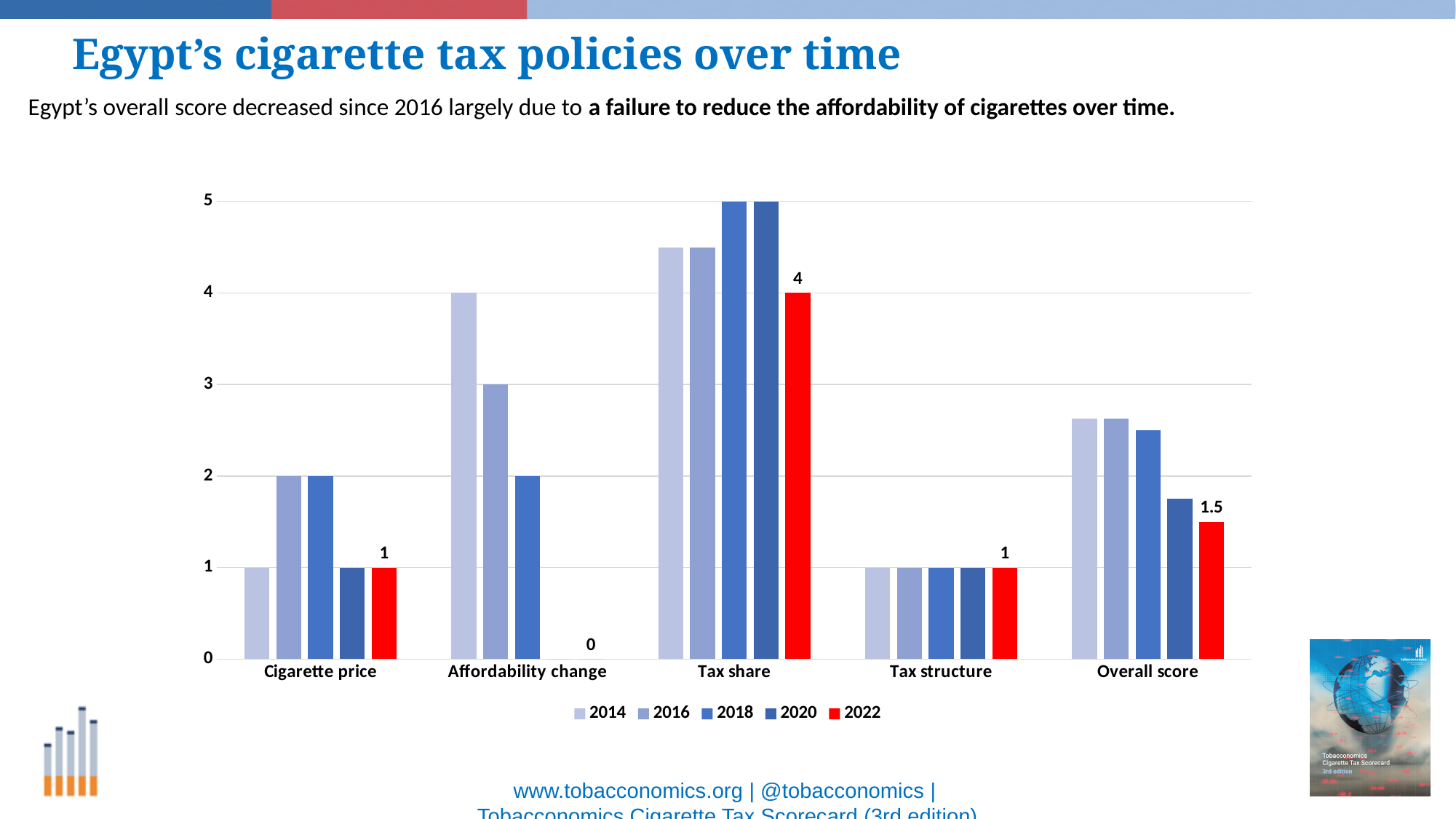
What is the value for Tax share in 2022? 4 Is the 2014 value for Overall score greater or less than 2? greater Which category has the lowest value for 2022? Affordability change What is the difference between the 2022 Tax share value and the 2022 Overall score? 2.5 Do the Affordability change values rise or fall from 2014 to 2022? fall What is the Overall score for 2022? 1.5 What is the value for Affordability change in 2022? 0 For 2022, which is larger: Cigarette price or Tax share? Tax share How many series does the legend list? 5 How many categories are shown on the x axis? 5 Which category has the highest value for 2022? Tax share What is the value for Tax share in 2018? 5